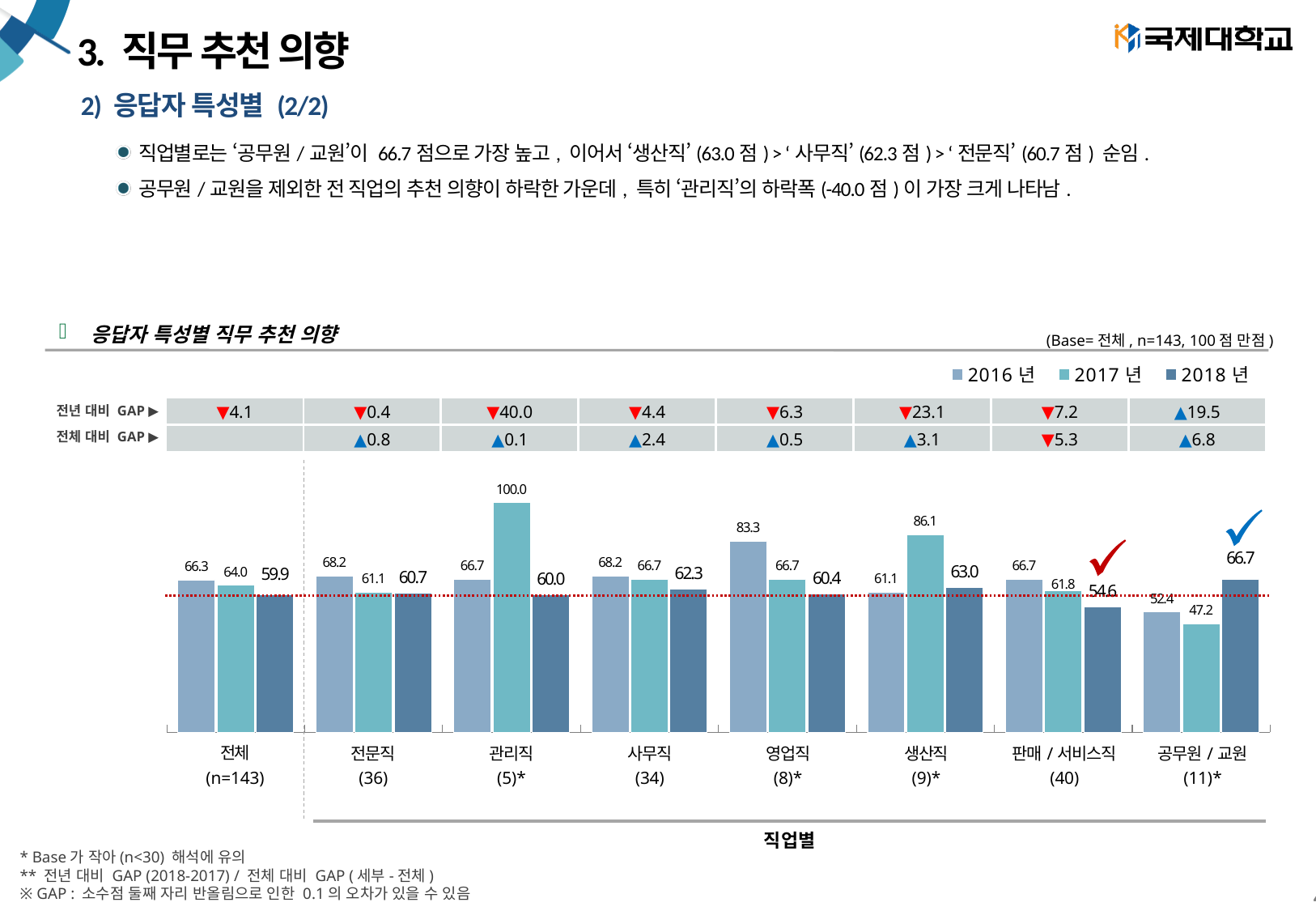
How many series does the legend list? 3 What is the 2017년 value for 생산직? 86.1 Which category has the lowest 2018년 value? 판매 / 서비스직 What is the 전년 대비 GAP shown for 관리직? ▼40.0 What kind of chart is shown on the slide? bar chart Which is larger, the 2016년 value for 전문직 or the 2016년 value for 공무원 / 교원? 전문직 Which category has the highest 2017년 value? 관리직 What is the 2018년 value for 공무원 / 교원? 66.7 How many categories are shown on the x axis of the chart? 8 What is the 2018년 value for 관리직? 60.0 What is the 2016년 value for 영업직? 83.3 What is the difference between the 2017년 and 2018년 values for 관리직? 40.0